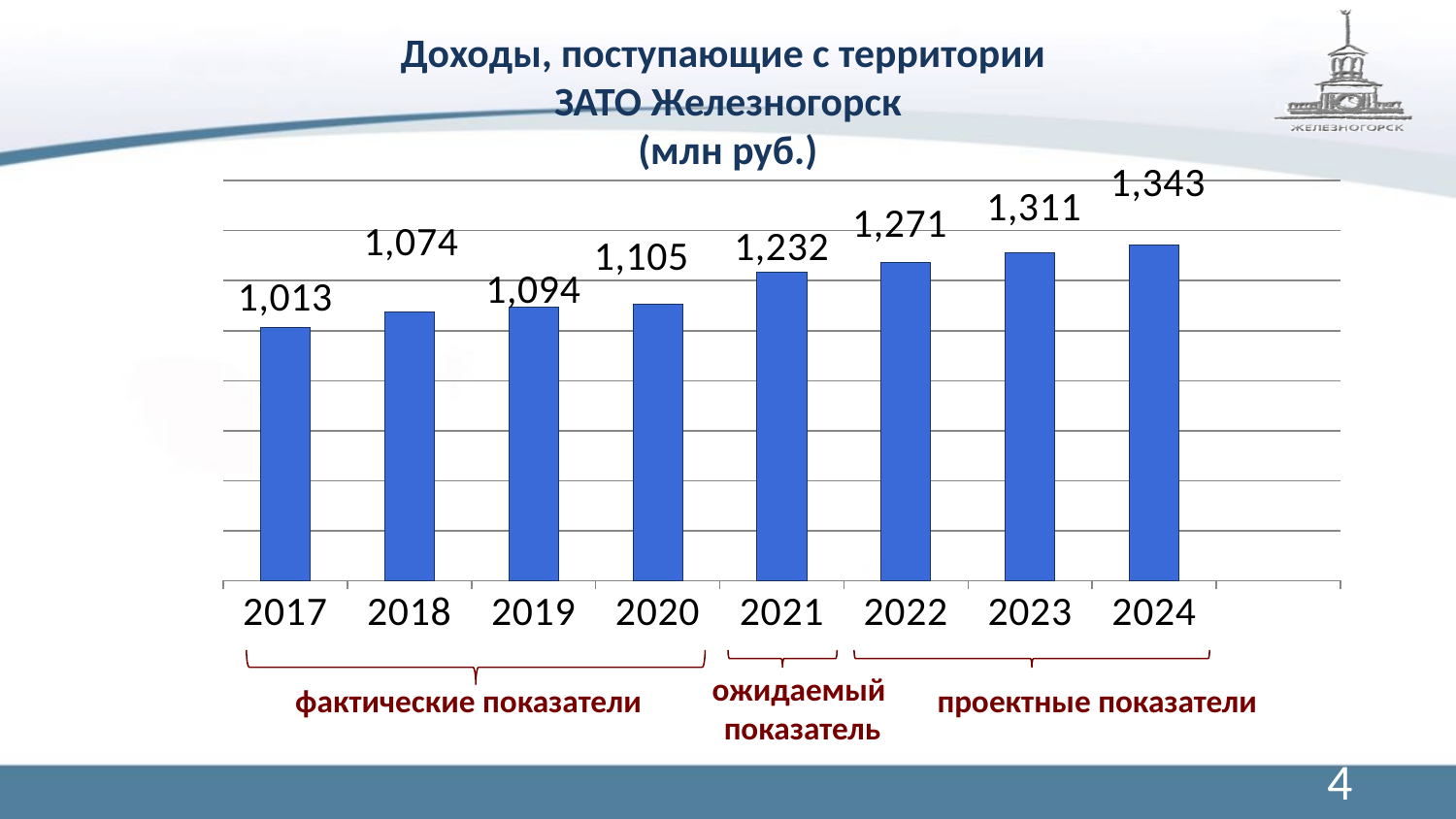
Which year has the highest value? 2024 What is the value for 2019? 1,094 Which is larger, the value for 2020 or the value for 2023? 2023 Which year has the lowest value? 2017 What is the value for 2024? 1,343 What is the difference between the values for 2022 and 2021? 39 What kind of chart is this? bar chart How many years are shown on the x axis? 8 What is the value for 2017? 1,013 What is the value for 2021? 1,232 What is the difference between the values for 2024 and 2017? 330 Do the values rise or fall from 2017 to 2024? rise